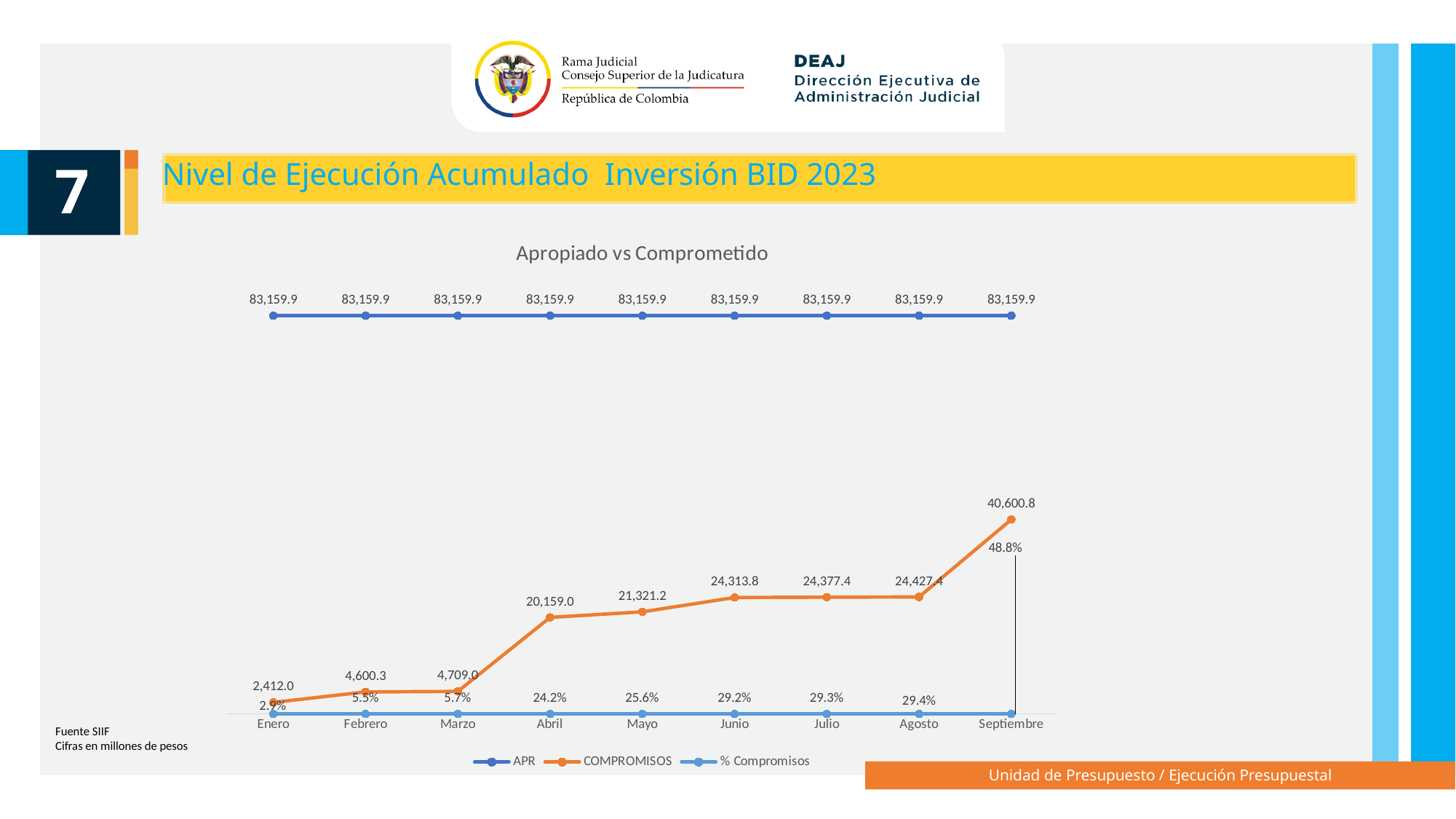
In which month is the COMPROMISOS value lowest? Enero What is the COMPROMISOS value for Septiembre? 40,600.8 What is the % Compromisos value for Junio? 29.2% Which is larger, the COMPROMISOS value for Abril or for Marzo? Abril What is the APR value for Abril? 83,159.9 In which month is the COMPROMISOS value highest? Septiembre How many series does the chart legend list? 3 What kind of chart is shown on the slide? line chart What is the difference between the COMPROMISOS values for Septiembre and Agosto? 16,173.4 What is the title of the chart? Apropiado vs Comprometido How many months are plotted along the x axis? 9 Does the COMPROMISOS series rise or fall from Enero to Septiembre? rise